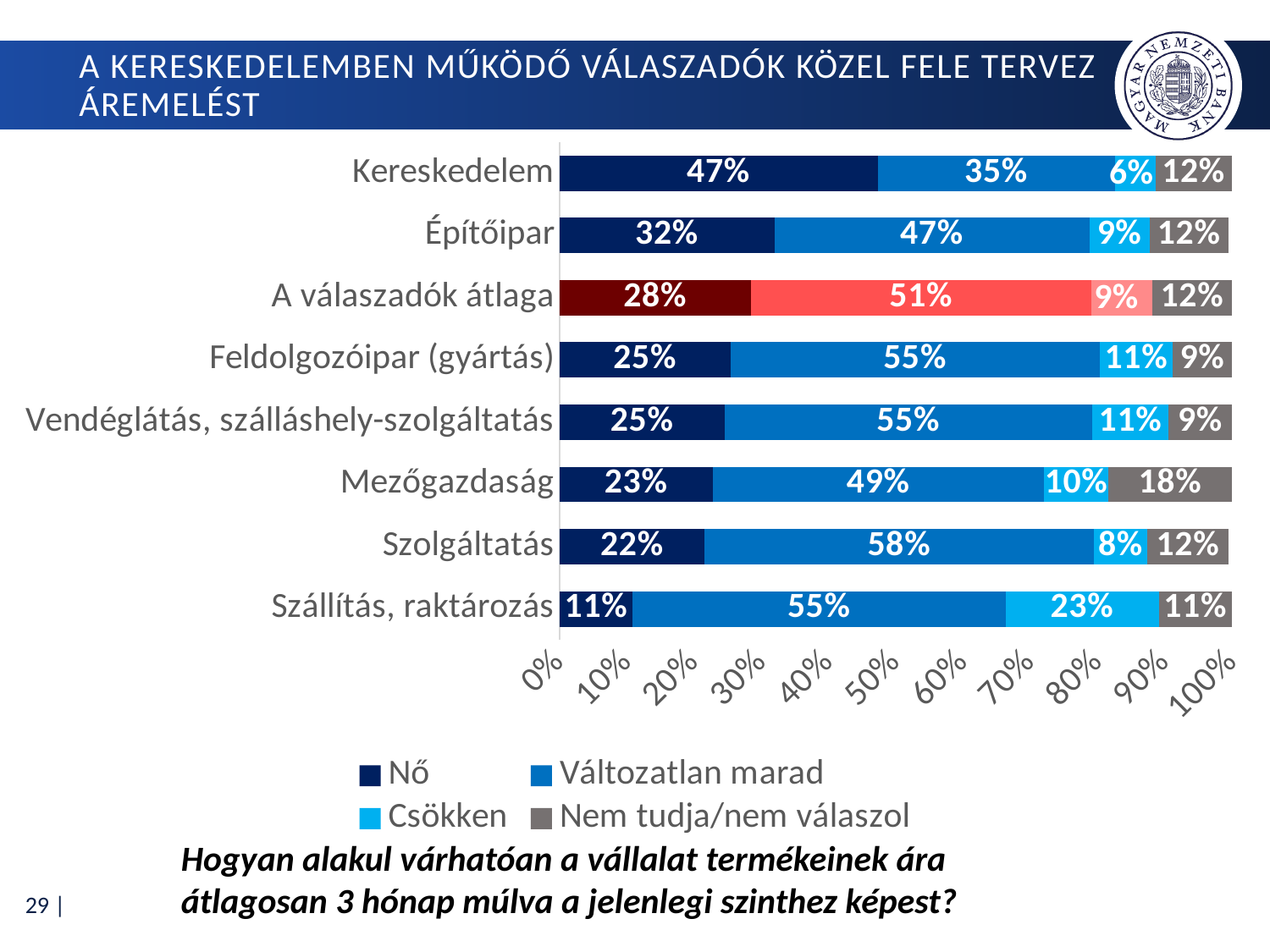
What kind of chart is shown on the slide? Stacked bar chart Which is larger: the 'Változatlan marad' value for Szolgáltatás or for Mezőgazdaság? Szolgáltatás What is the total of the stacked bar for Feldolgozóipar (gyártás)? 100% Which category has the lowest 'Nő' value? Szállítás, raktározás What is the difference between the 'Nő' values for Kereskedelem and Építőipar? 15% What is the 'Csökken' value for Szállítás, raktározás? 23% How many categories are shown on the chart? 8 What is the 'Nem tudja/nem válaszol' value for Mezőgazdaság? 18% What is the 'Nő' value for Kereskedelem? 47% How many series does the legend list? 4 What is the 'Változatlan marad' value for Szolgáltatás? 58% Which category has the highest 'Nő' value? Kereskedelem